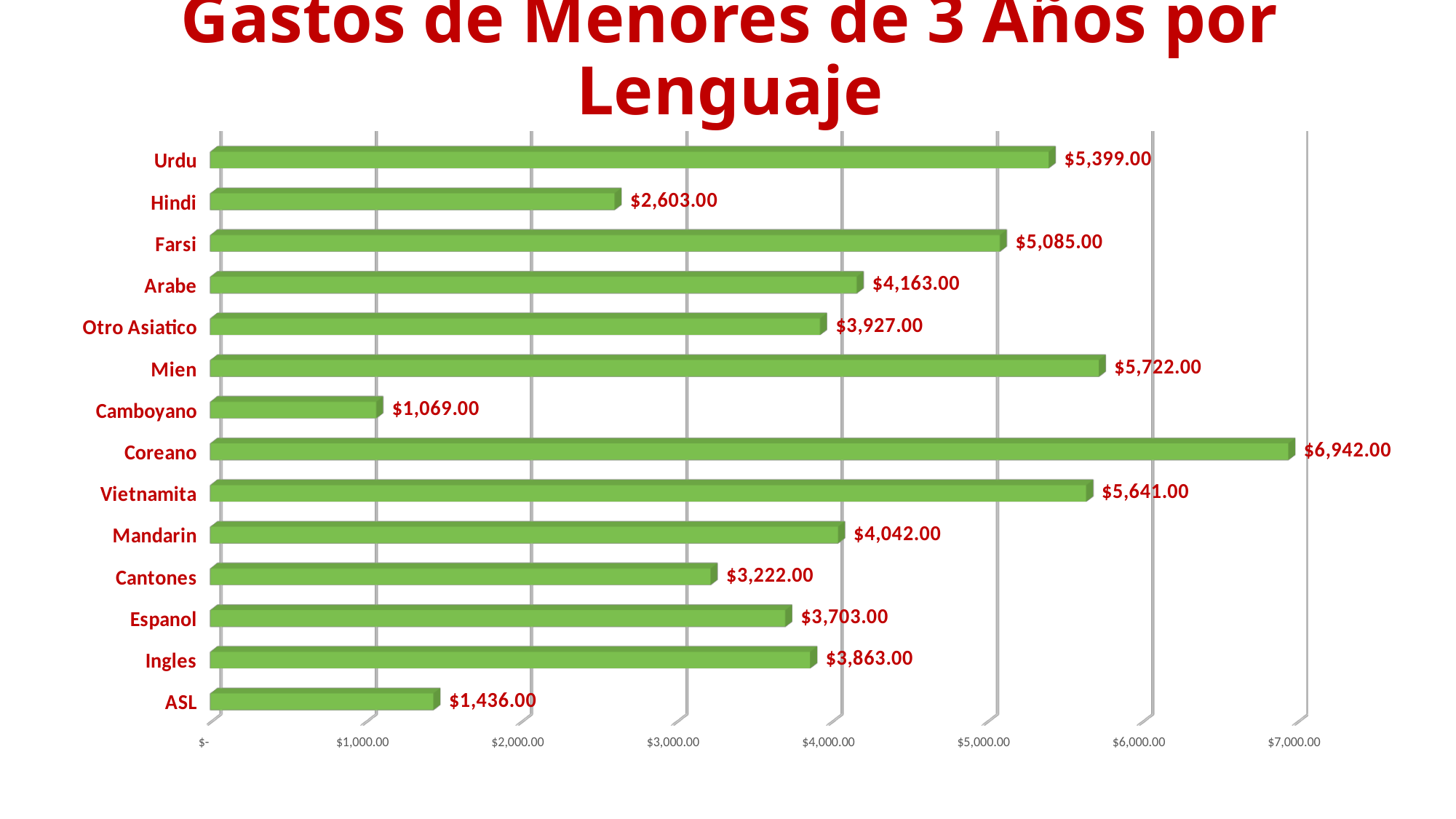
How many languages are shown in the chart? 14 What is the difference between the values for Urdu and Hindi? $2,796.00 Which language has the highest value? Coreano What is the value for Coreano? $6,942.00 What colour are the bars in the chart? green Is the value for Arabe greater or less than $4,000.00? greater What is the value for Espanol? $3,703.00 Which is larger, the value for Mien or the value for Vietnamita? Mien What is the value for Camboyano? $1,069.00 What kind of chart is this? bar chart What is the title of the chart? Gastos de Menores de 3 Años por Lenguaje Which language has the lowest value? Camboyano